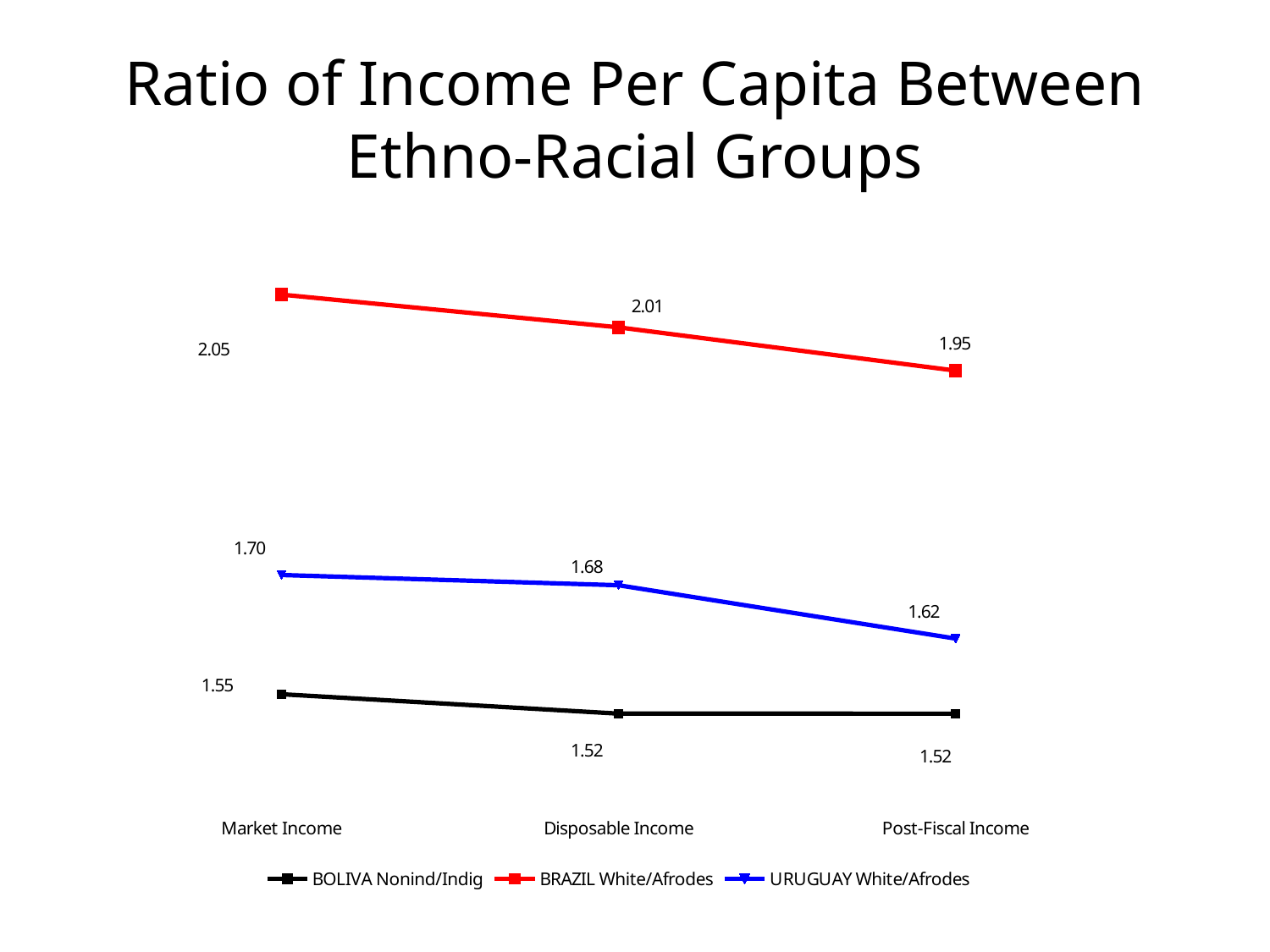
What type of chart is shown on the slide? line chart Which series has the lowest value at Post-Fiscal Income? BOLIVA Nonind/Indig Which series has the highest value at Market Income? BRAZIL White/Afrodes What is the value for BRAZIL White/Afrodes at Market Income? 2.05 How many series does the legend list? 3 What is the title of the chart? Ratio of Income Per Capita Between Ethno-Racial Groups How many income categories are shown on the x axis? 3 Which is larger: the URUGUAY White/Afrodes value at Market Income or the BOLIVA Nonind/Indig value at Market Income? URUGUAY White/Afrodes What is the value for URUGUAY White/Afrodes at Disposable Income? 1.68 Does the BRAZIL White/Afrodes series rise or fall from Market Income to Post-Fiscal Income? fall What is the value for BOLIVA Nonind/Indig at Post-Fiscal Income? 1.52 What is the difference between the BRAZIL White/Afrodes values at Market Income and Post-Fiscal Income? 0.10